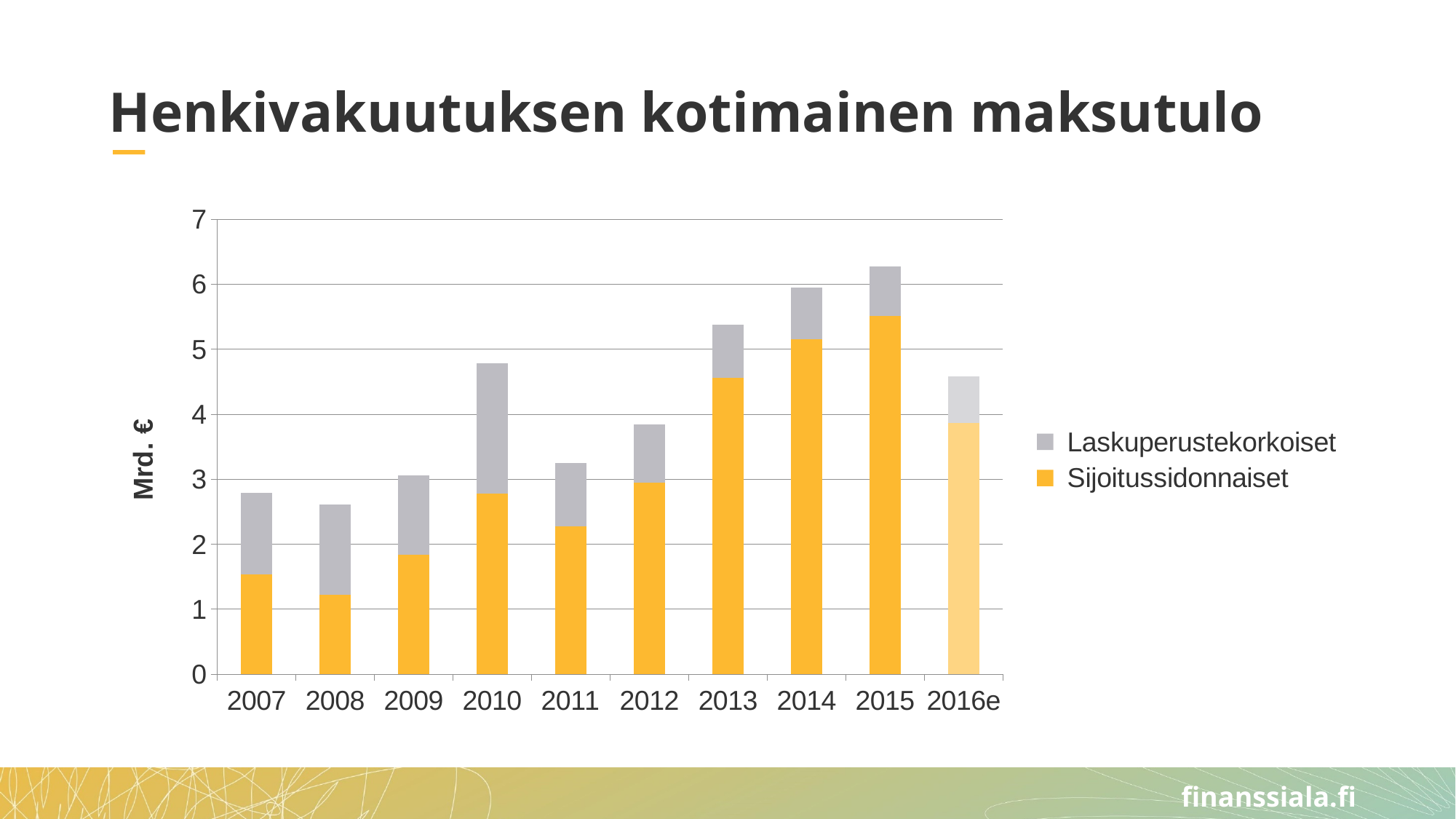
How many series does the legend list? 2 What is the label on the y axis? Mrd. € Is the total value for 2015 greater or less than 6? greater Do the total bars rise or fall from 2012 to 2015? Rise How many years are shown on the x axis? 10 Which year has the highest total bar? 2015 Is the total value for 2008 greater or less than 3? less Which year has the larger total bar, 2010 or 2011? 2010 Which year has the lowest total bar? 2008 Is the Sijoitussidonnaiset value for 2013 greater or less than 4? greater What kind of chart is shown on the slide? Stacked bar chart